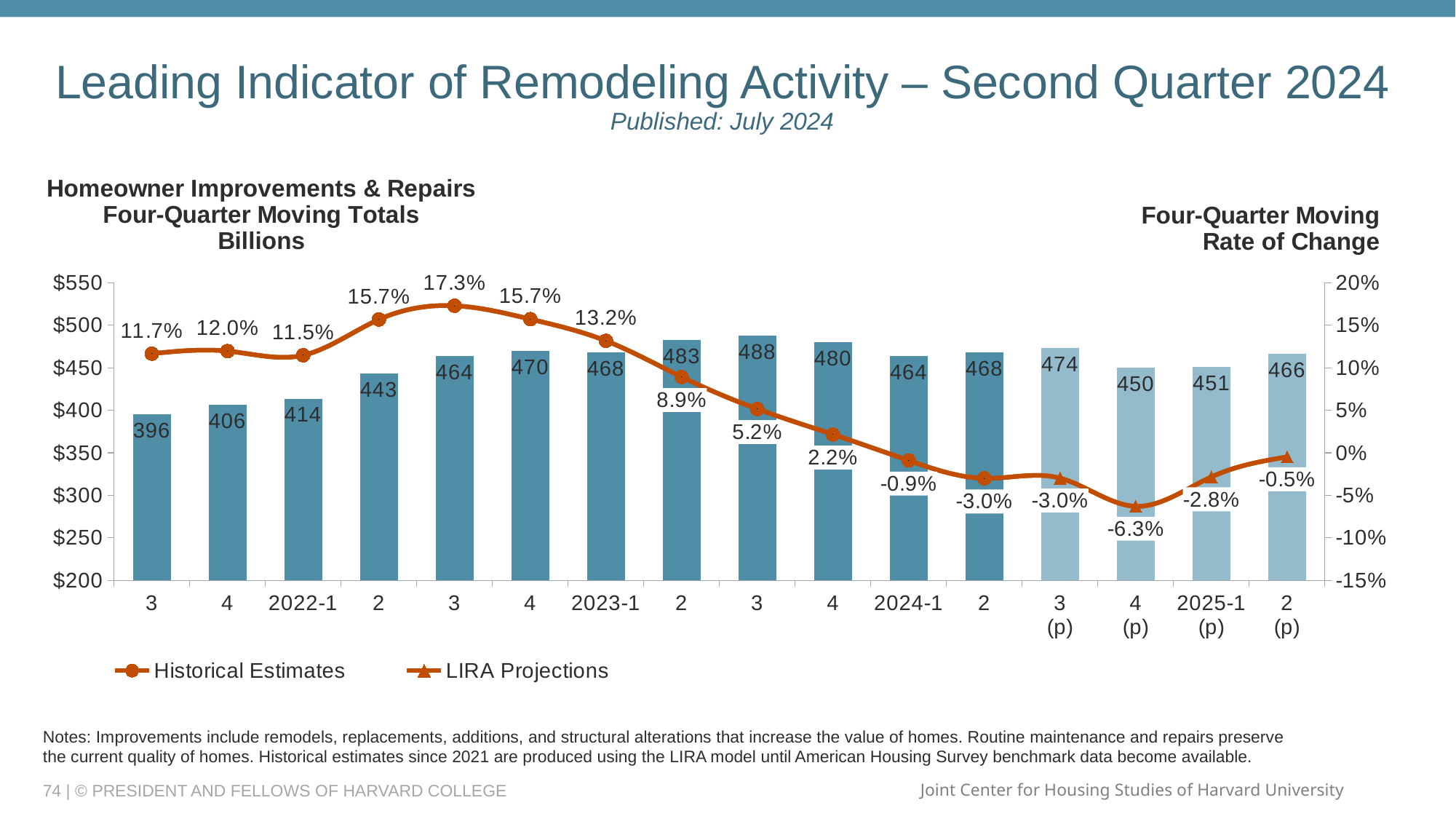
What is the projected four-quarter moving total for 2025-1 (p)? 451 Does the rate of change line rise or fall from 2022-3 to 2024-4 (p)? Fall What is the difference between the highest bar (2023-3) and the lowest bar (the first bar, 2021-3)? 92 What is the four-quarter moving rate of change for 2022-3? 17.3% What is the four-quarter moving total (in billions) for 2023-1? 468 How many quarters (bars) are shown on the chart? 16 What is the projected rate of change for 2024-4 (p)? -6.3% Which is larger, the four-quarter moving total for 2022-2 or for 2024-4 (p)? 2024-4 (p) How many series does the legend list? 2 Which quarter has the lowest four-quarter moving rate of change? 2024-4 (p) Which quarter has the highest four-quarter moving total bar? 2023-3 What kind of chart is this? Combination bar and line chart